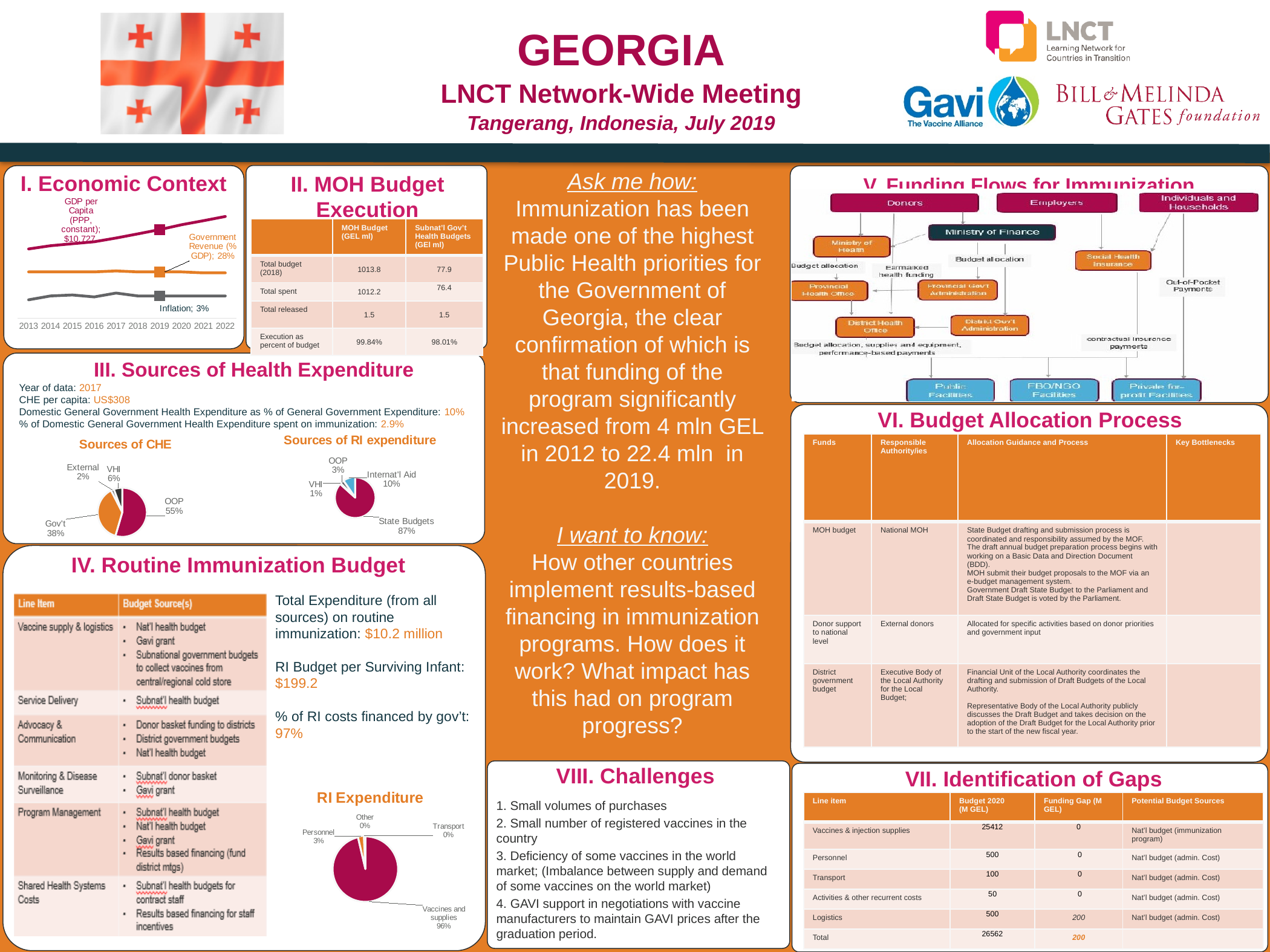
In the 'Sources of CHE' pie chart, which source has the smallest share? External How many slices does the 'Sources of CHE' pie chart have? 4 How many years are shown on the x axis of the 'I. Economic Context' line chart? 10 In the 'Sources of CHE' pie chart, what share is labelled for OOP? 55% In the 'Sources of RI expenditure' pie chart, which is larger, Internat'l Aid or OOP? Internat'l Aid In the 'RI Expenditure' pie chart, what share is labelled for Vaccines and supplies? 96% In the 'Sources of RI expenditure' pie chart, what share is labelled for VHI? 1% In the 'RI Expenditure' pie chart, what share is labelled for Personnel? 3% In the 'Sources of CHE' pie chart, what is the difference between the OOP share and the Gov't share? 17% In the 'I. Economic Context' line chart, what value is labelled for Inflation? 3% In the 'Sources of RI expenditure' pie chart, what share is labelled for State Budgets? 87% What kind of chart is the 'RI Expenditure' chart? Pie chart